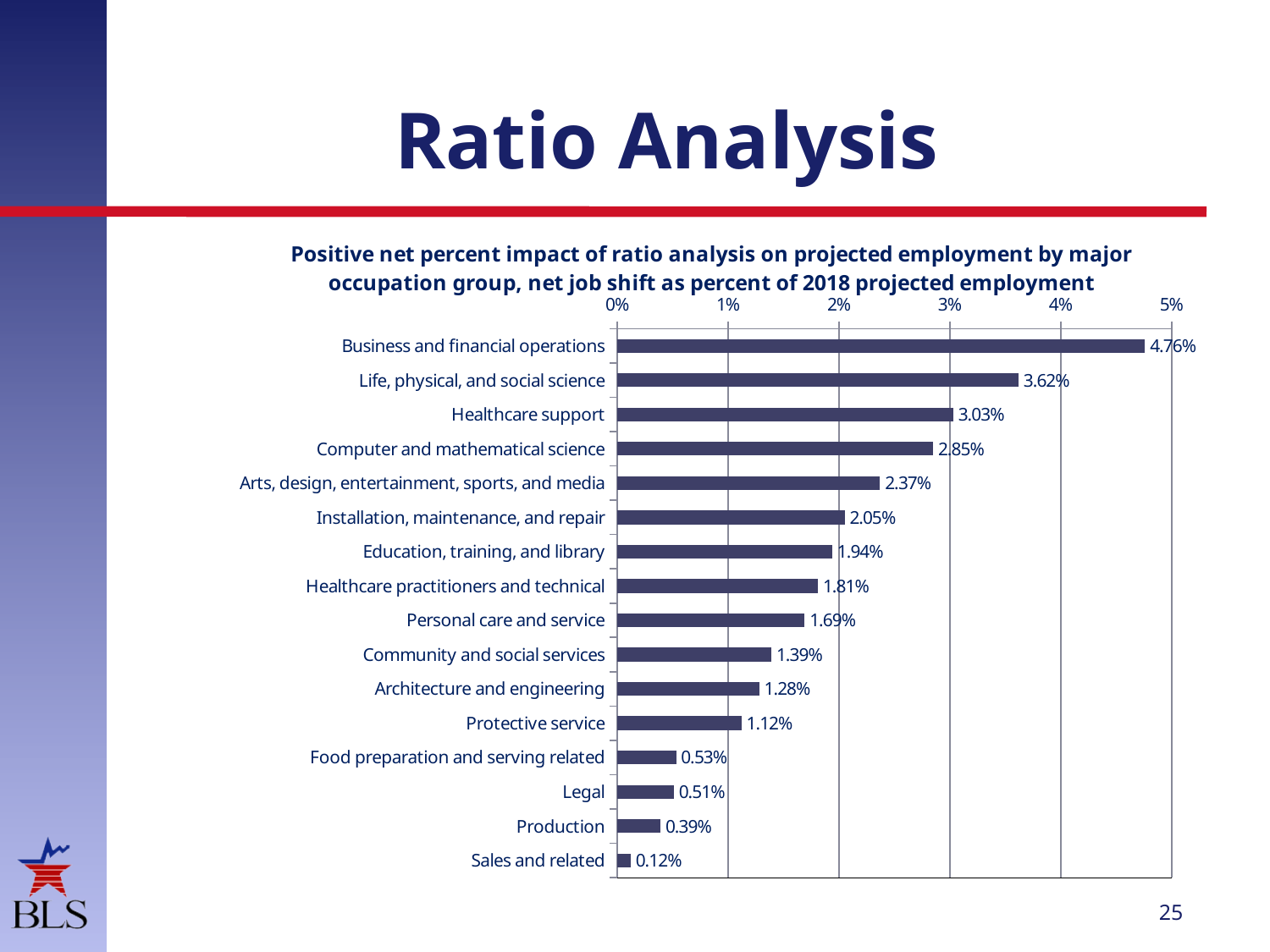
What is the difference between the values for Healthcare support and Computer and mathematical science? 0.18% Which occupation group has the highest value? Business and financial operations Which is larger, the value for Education, training, and library or the value for Personal care and service? Education, training, and library What is the value for Community and social services? 1.39% Is the value for Arts, design, entertainment, sports, and media greater or less than 2%? greater How many occupation groups are shown in the chart? 16 What is the difference between the values for Business and financial operations and Life, physical, and social science? 1.14% What is the highest value shown on the horizontal axis? 5% What is the value for Healthcare support? 3.03% What kind of chart is shown on the slide? Bar chart What is the value for Production? 0.39% Which occupation group has the lowest value? Sales and related